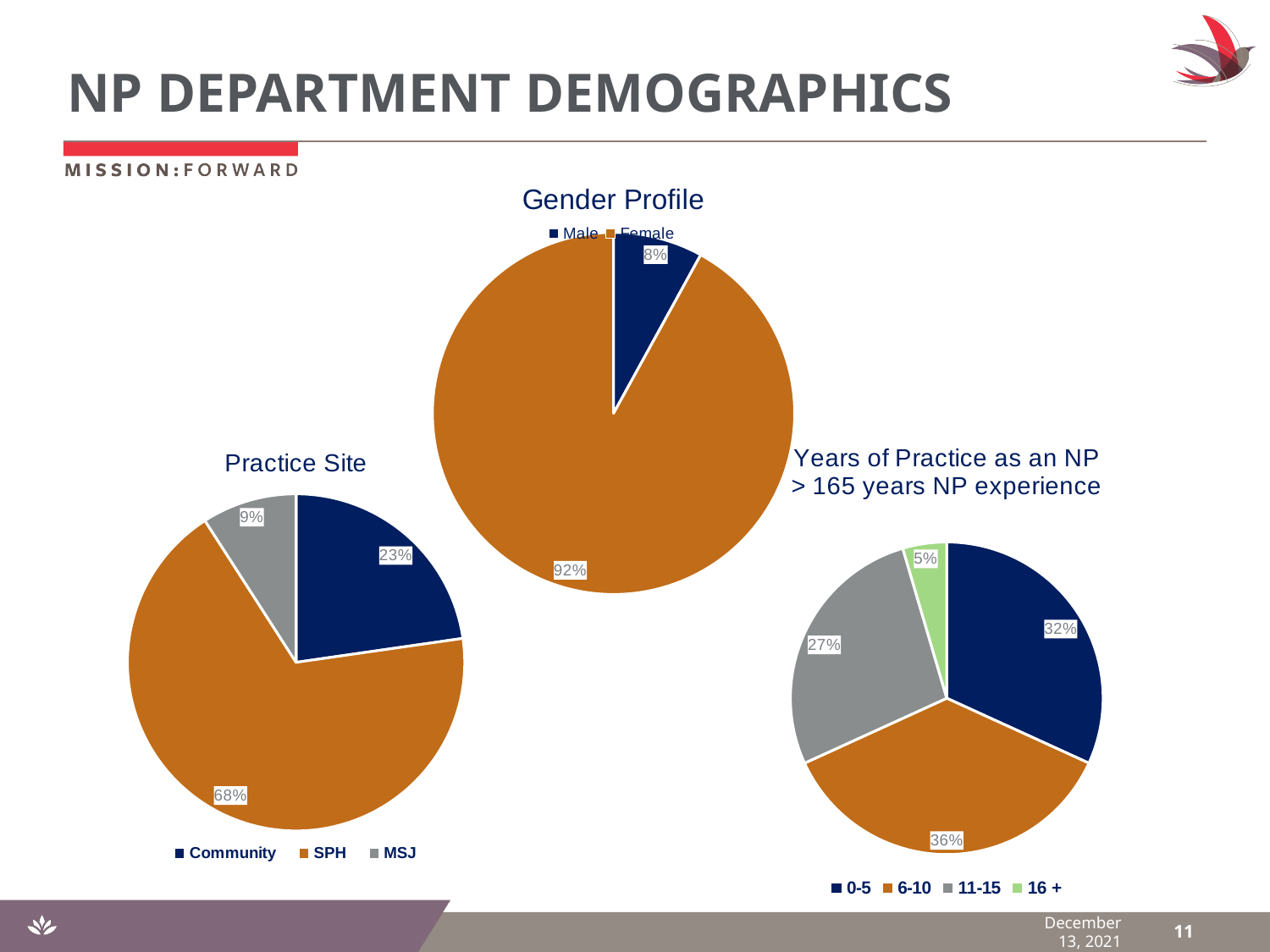
In the Practice Site chart, which site has the smallest share? MSJ In the Gender Profile chart, what percentage is Female? 92% In the Years of Practice as an NP chart, which category has the largest share? 6-10 In the Practice Site chart, what percentage is SPH? 68% In the Years of Practice as an NP chart, which category has the smallest share? 16 + In the Practice Site chart, what is the difference between the Community and MSJ shares? 14% In the Gender Profile chart, what percentage is Male? 8% What kind of chart is the Practice Site chart? Pie chart In the Practice Site chart, how many categories does the legend list? 3 In the Years of Practice as an NP chart, how many categories does the legend list? 4 In the Years of Practice as an NP chart, which is larger: 0-5 or 11-15? 0-5 In the Years of Practice as an NP chart, what percentage is 6-10 years? 36%